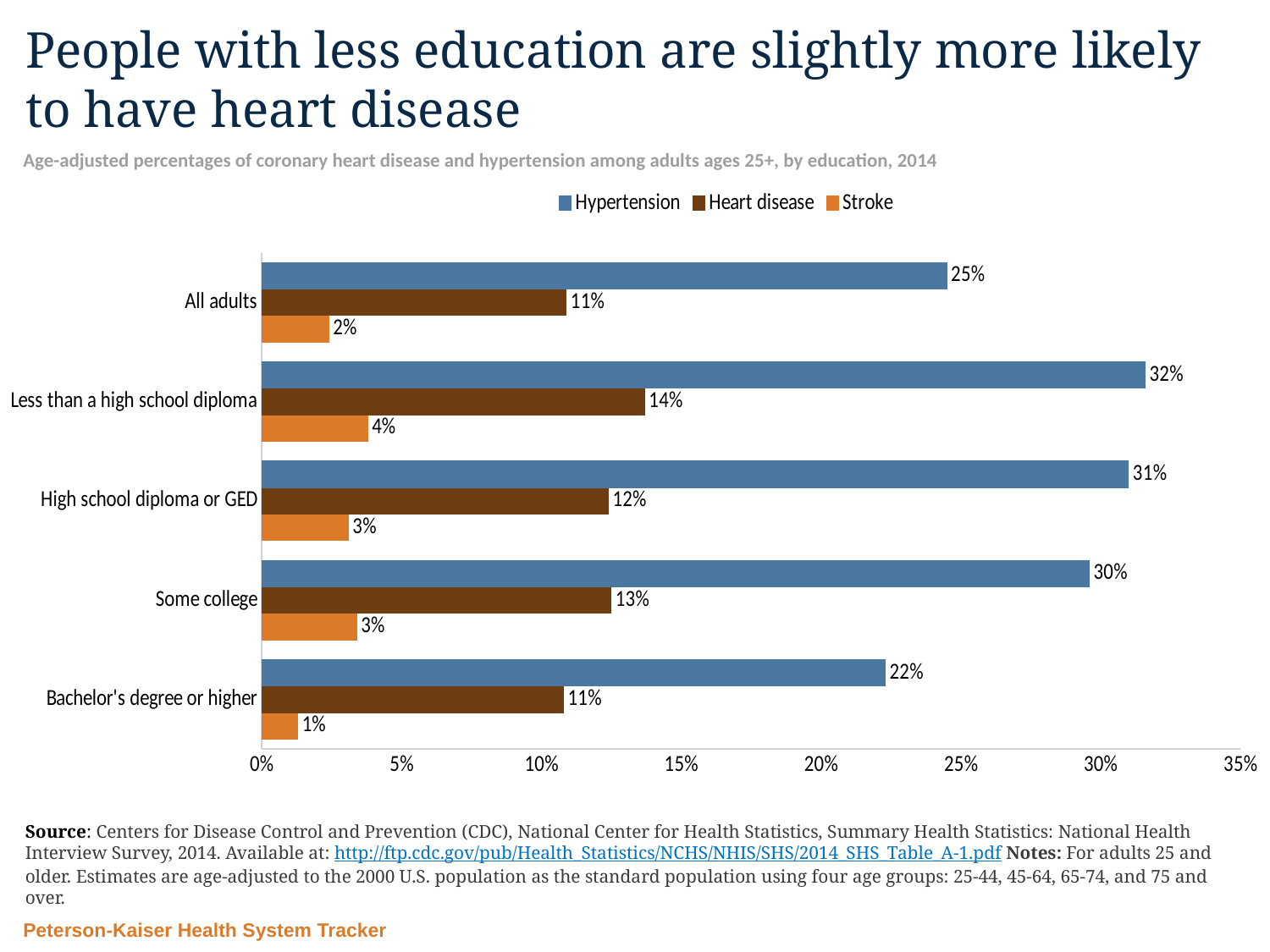
What is the heart disease percentage for adults with some college? 13% How many education categories are shown on the chart? 5 What is the hypertension percentage for adults with less than a high school diploma? 32% Which series is shown in orange in the legend? Stroke How many series does the legend list? 3 Which education group has the lowest hypertension percentage? Bachelor's degree or higher Which is larger: the heart disease percentage for high school diploma or GED, or for some college? Some college What kind of chart is shown on the slide? Bar chart What is the stroke percentage for adults with a bachelor's degree or higher? 1% Is the hypertension value for all adults greater or less than 20%? greater Which education group has the highest hypertension percentage? Less than a high school diploma What is the difference in hypertension percentage between adults with less than a high school diploma and those with a bachelor's degree or higher? 10 percentage points